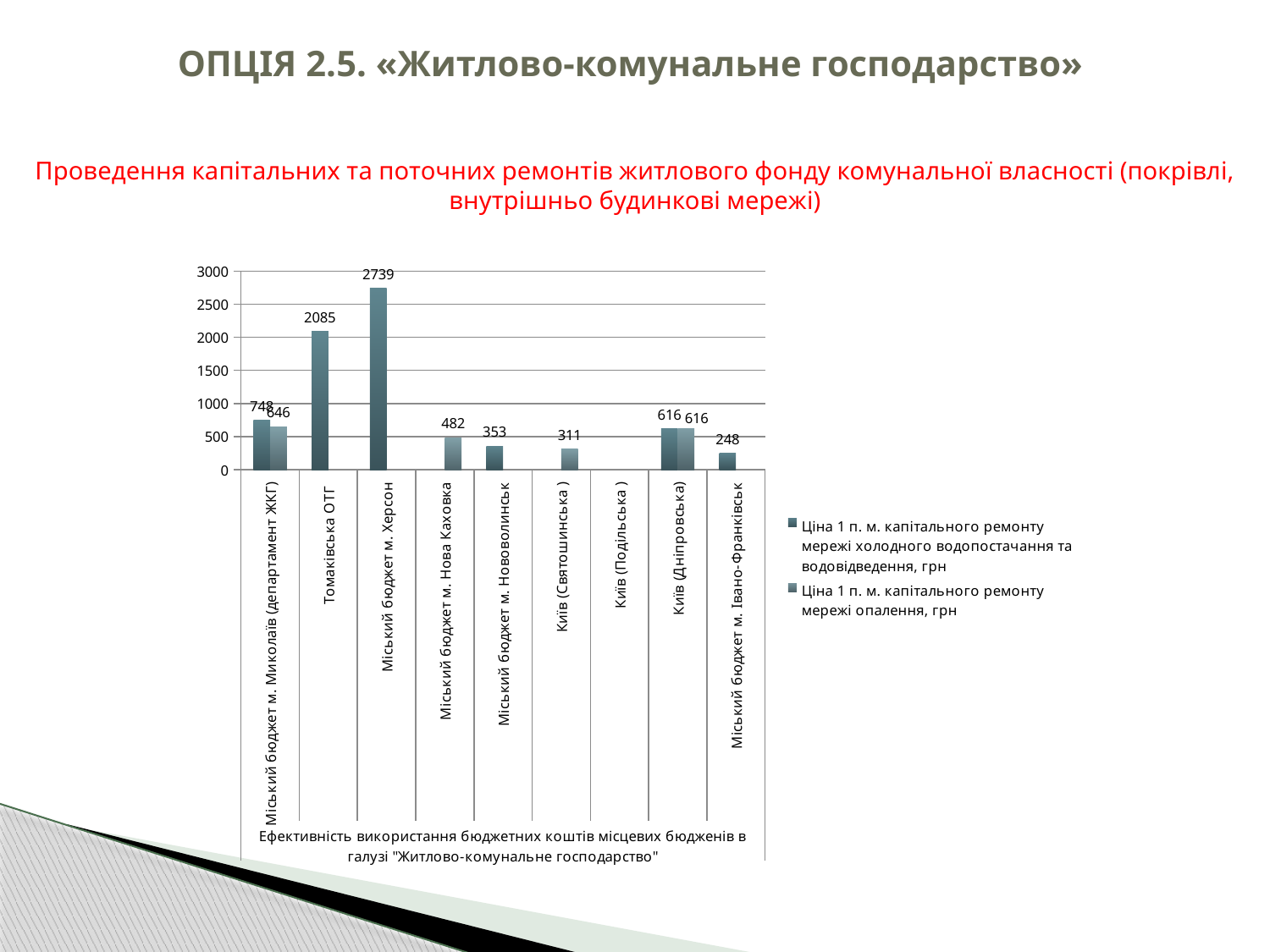
Which category has the highest value in the chart? Міський бюджет м. Херсон What is the difference between the values for Міський бюджет м. Херсон and Томаківська ОТГ? 654 What is the difference between the two values shown for Міський бюджет м. Миколаїв (департамент ЖКГ)? 102 What kind of chart is shown on the slide? bar chart What value is shown for both series for Київ (Дніпровська)? 616 What is the value shown for Київ (Святошинська)? 311 What is the value shown for Томаківська ОТГ? 2085 What is the value shown for Міський бюджет м. Івано-Франківськ? 248 How many series does the chart legend list? 2 Which has the larger value: Міський бюджет м. Нова Каховка or Міський бюджет м. Нововолинськ? Міський бюджет м. Нова Каховка How many categories are shown along the x axis of the chart? 9 What is the value shown for Міський бюджет м. Херсон? 2739